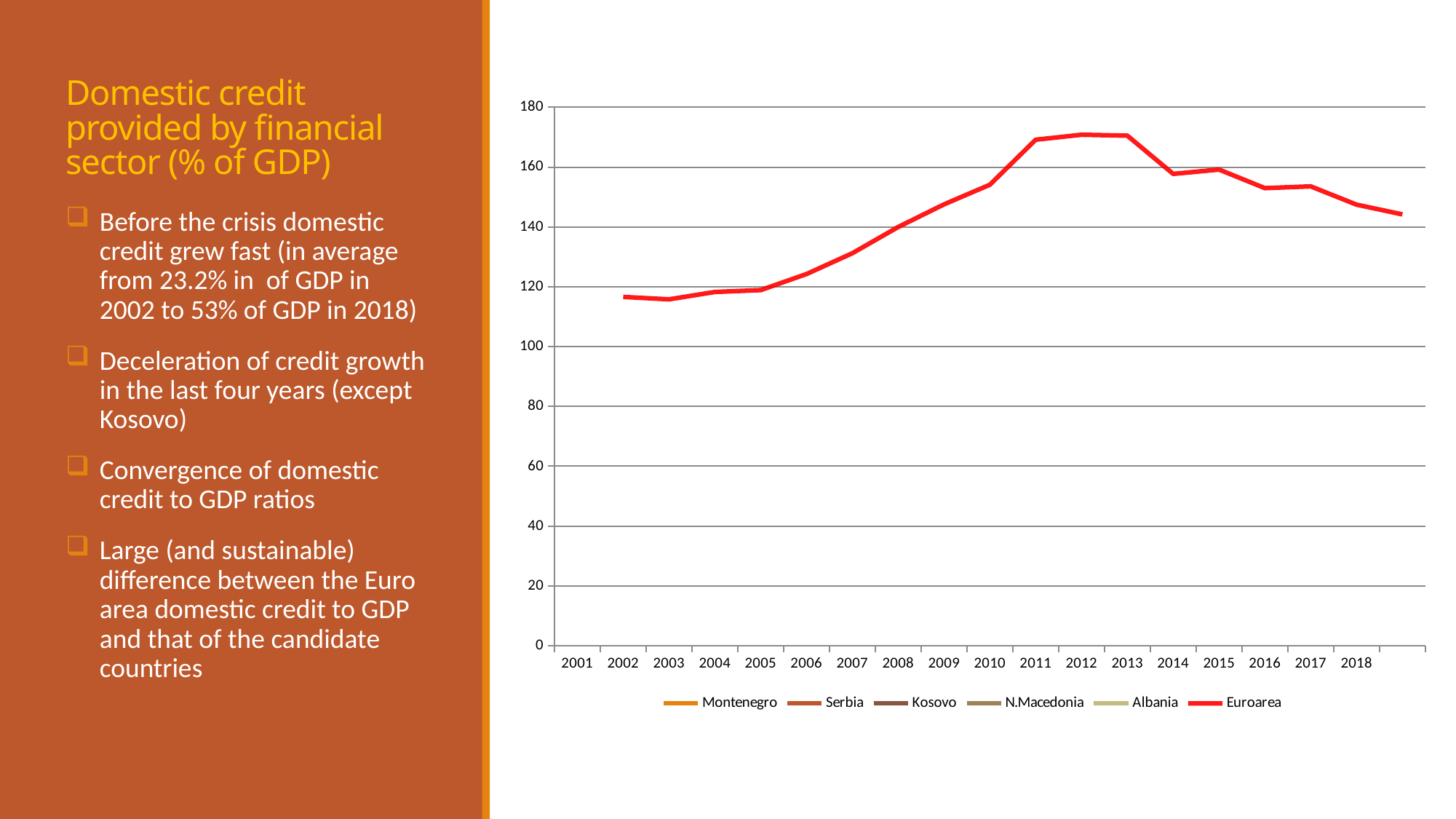
Is the Euroarea value for 2005 greater or less than 140? less Is the Euroarea value for 2016 greater or less than 140? greater Is the Euroarea value for 2011 greater or less than 160? greater Which is larger for Euroarea, the value in 2002 or the value in 2011? 2011 Which is larger for Euroarea, the value in 2012 or the value in 2018? 2012 What kind of chart is shown on the slide? line chart Does the Euroarea line rise or fall between 2002 and 2012? rise How many series does the chart legend list? 6 Which series is plotted as the red line on the chart? Euroarea